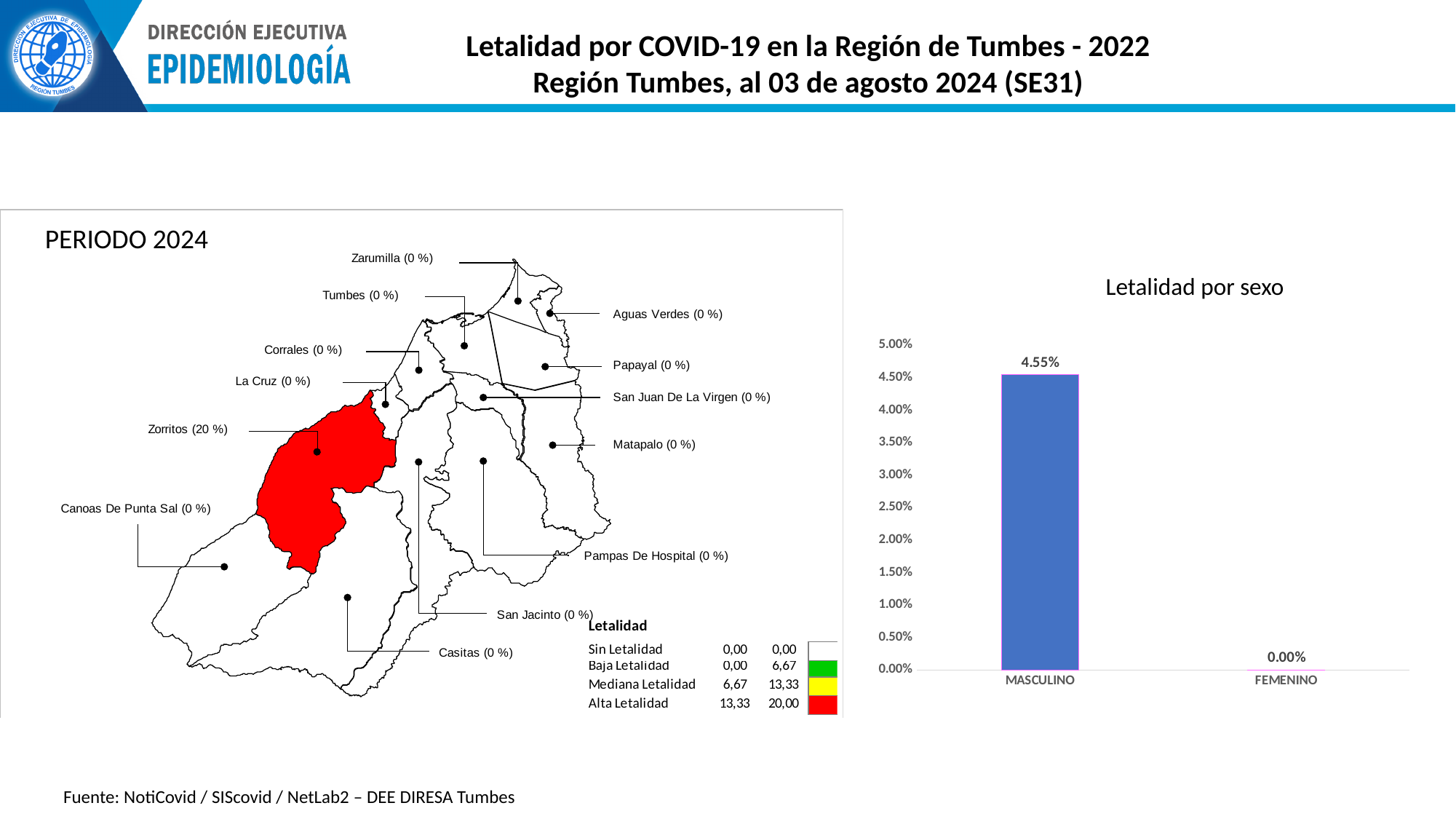
In the 'Letalidad por sexo' chart, which category has the highest value? MASCULINO In the 'Letalidad por sexo' chart, what is the value for FEMENINO? 0.00% In the 'Letalidad por sexo' chart, what is the value for MASCULINO? 4.55% In the 'Letalidad por sexo' chart, is the value for MASCULINO greater or less than 4.00%? greater In the 'Letalidad por sexo' chart, what is the difference between the MASCULINO and FEMENINO values? 4.55% What is the title of the bar chart on the right side of the slide? Letalidad por sexo In the 'Letalidad por sexo' chart, how many categories are shown on the x axis? 2 On the map 'PERIODO 2024', what lethality percentage is shown for Zorritos? 20 % In the 'Letalidad por sexo' chart, which category has the lowest value? FEMENINO In the 'Letalidad por sexo' chart, what is the highest value shown on the y axis? 5.00% On the map 'PERIODO 2024', which district is shaded red? Zorritos What kind of chart is 'Letalidad por sexo'? bar chart